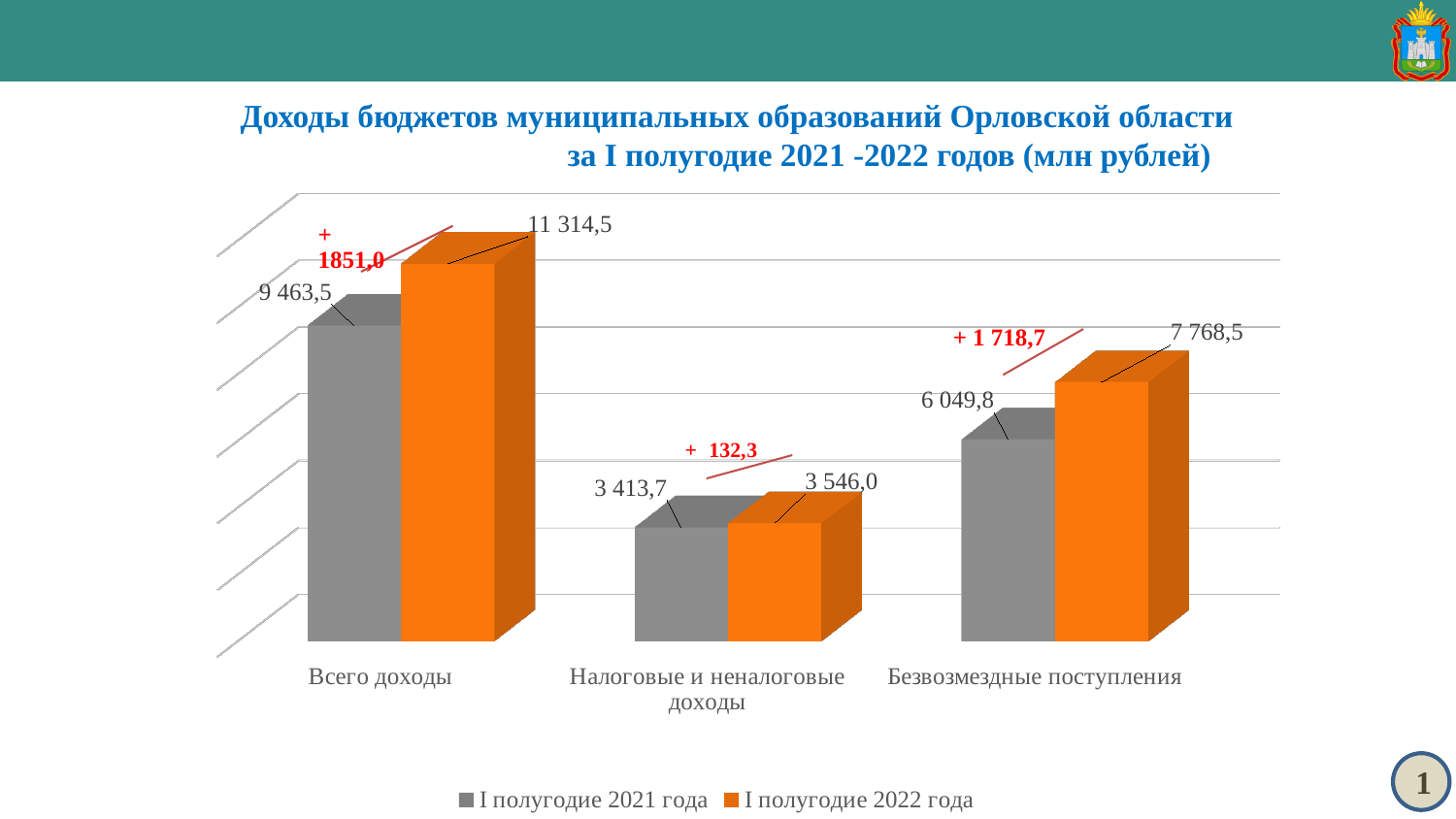
Which is larger for «Безвозмездные поступления»: the value for «I полугодие 2021 года» or «I полугодие 2022 года»? I полугодие 2022 года What is the value for «Безвозмездные поступления» in the series «I полугодие 2021 года»? 6 049,8 Which category has the lowest value in the series «I полугодие 2021 года»? Налоговые и неналоговые доходы How many categories are shown on the x axis of the chart? 3 What is the value for «Всего доходы» in the series «I полугодие 2022 года»? 11 314,5 What is the value for «Всего доходы» in the series «I полугодие 2021 года»? 9 463,5 What is the value for «Налоговые и неналоговые доходы» in the series «I полугодие 2022 года»? 3 546,0 Which category has the highest value in the series «I полугодие 2022 года»? Всего доходы What kind of chart is shown on the slide? Bar chart How many series does the legend list? 2 What is the difference between the 2022 and 2021 values for «Налоговые и неналоговые доходы»? 132,3 What is the difference between the 2022 and 2021 values for «Безвозмездные поступления»? 1 718,7